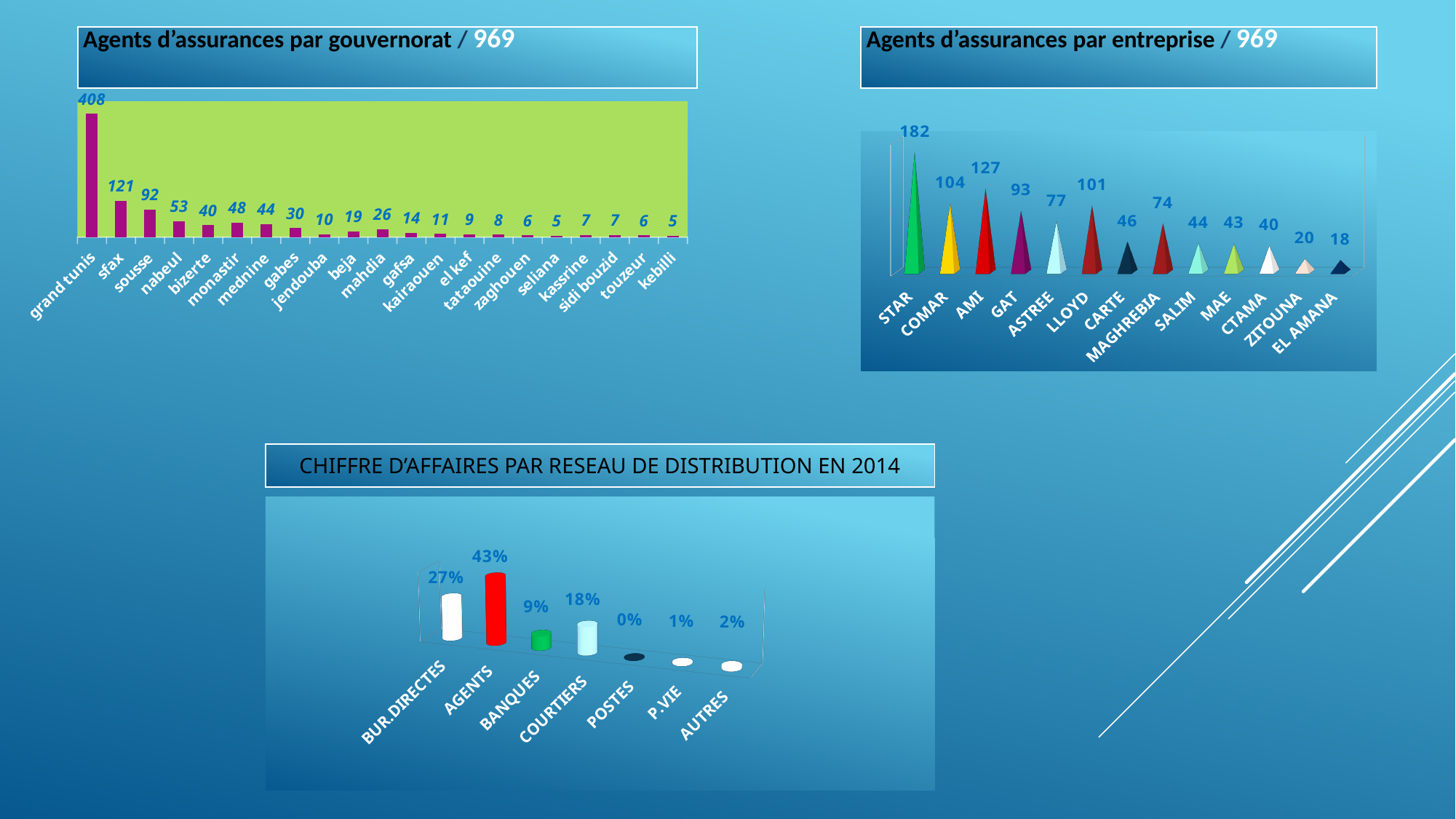
In the chart 'Agents d'assurances par gouvernorat', how many gouvernorats are shown? 21 In the chart 'Agents d'assurances par gouvernorat', which gouvernorat has the highest number of agents? grand tunis In the chart 'Agents d'assurances par gouvernorat', how many agents are in sfax? 121 In the chart 'Agents d'assurances par entreprise', how many companies are shown? 13 In the chart 'Agents d'assurances par entreprise', which company has the lowest number of agents? EL AMANA In the chart 'Chiffre d'affaires par reseau de distribution en 2014', what is the value for COURTIERS? 18% In the chart 'Agents d'assurances par entreprise', which has more agents, COMAR or AMI? AMI In the chart 'Chiffre d'affaires par reseau de distribution en 2014', which distribution network has the highest share? AGENTS In the chart 'Agents d'assurances par entreprise', how many agents does STAR have? 182 In the chart 'Agents d'assurances par gouvernorat', what is the difference between grand tunis and sfax? 287 In the chart 'Chiffre d'affaires par reseau de distribution en 2014', what is the difference between AGENTS and BUR.DIRECTES? 16% What kind of chart is 'Agents d'assurances par gouvernorat'? bar chart